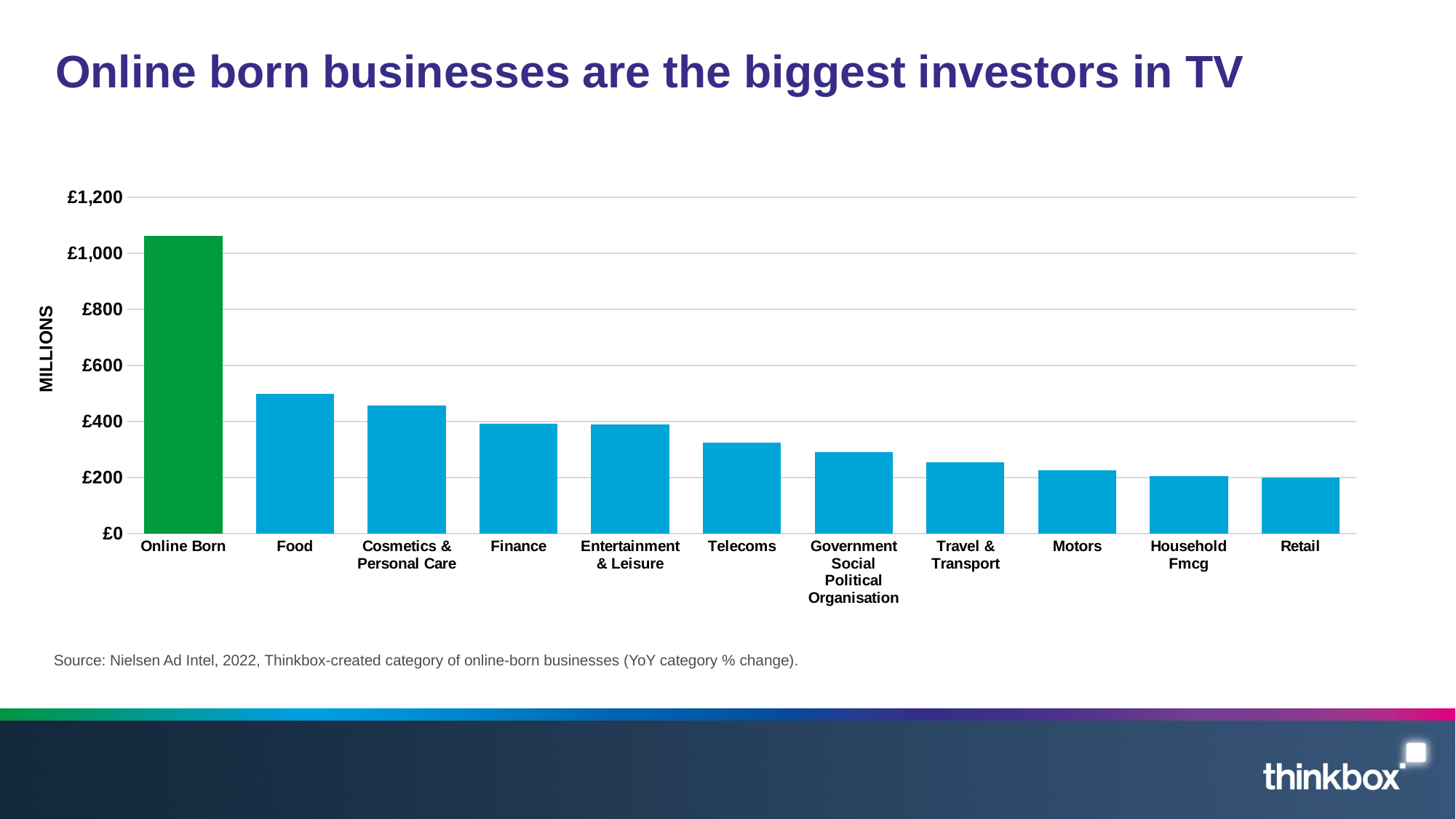
Which category has the highest value? Online Born Which is larger, the value for Online Born or the value for Food? Online Born How many categories are shown on the x axis? 11 Is the value for Food greater or less than £400? greater Is the value for Government Social Political Organisation greater or less than £400? less What is the label on the y axis? MILLIONS Do the values rise or fall moving from left to right along the x axis? Fall What kind of chart is shown on the slide? Bar chart Which is larger, the value for Telecoms or the value for Motors? Telecoms Is the value for Cosmetics & Personal Care greater or less than £600? less